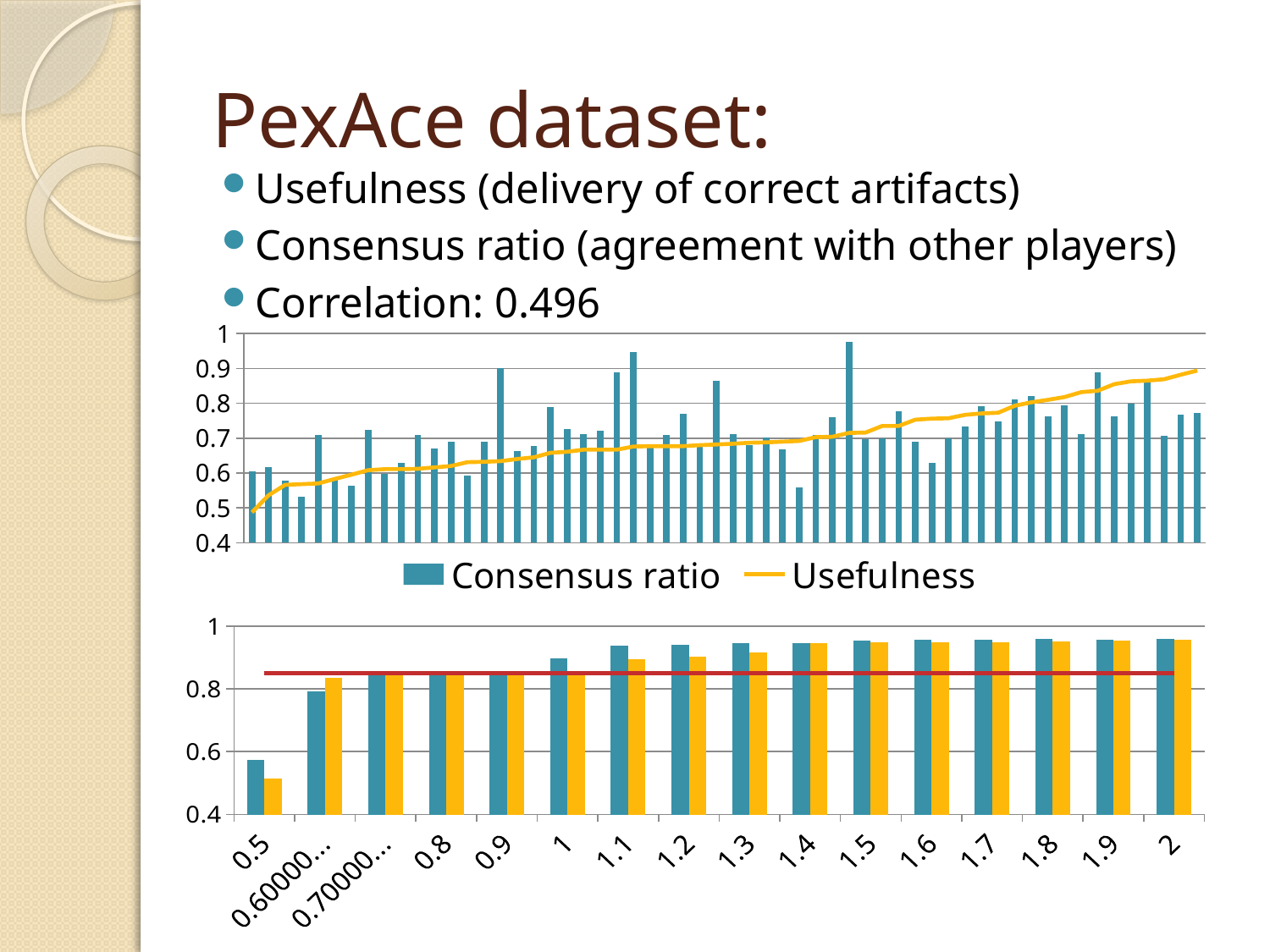
In the top chart, which series is drawn as a line rather than bars? Usefulness In the bottom chart, which category has the lowest values for both series? 0.5 In the bottom chart, how many categories are shown on the x axis? 16 In the bottom chart, is the yellow bar for category 0.5 greater or less than 0.6? less In the bottom chart, is the teal bar for category 2 greater or less than 0.8? greater In the bottom chart, for category 1, which bar is taller, the teal one or the yellow one? teal In the top chart, does the Usefulness line rise or fall from left to right? rise In the top chart, is the tallest Consensus ratio bar greater or less than 0.9? greater In the top chart, how many series does the legend list? 2 In the top chart, what are the two entries in the legend? Consensus ratio and Usefulness What kind of chart is the bottom chart? bar chart